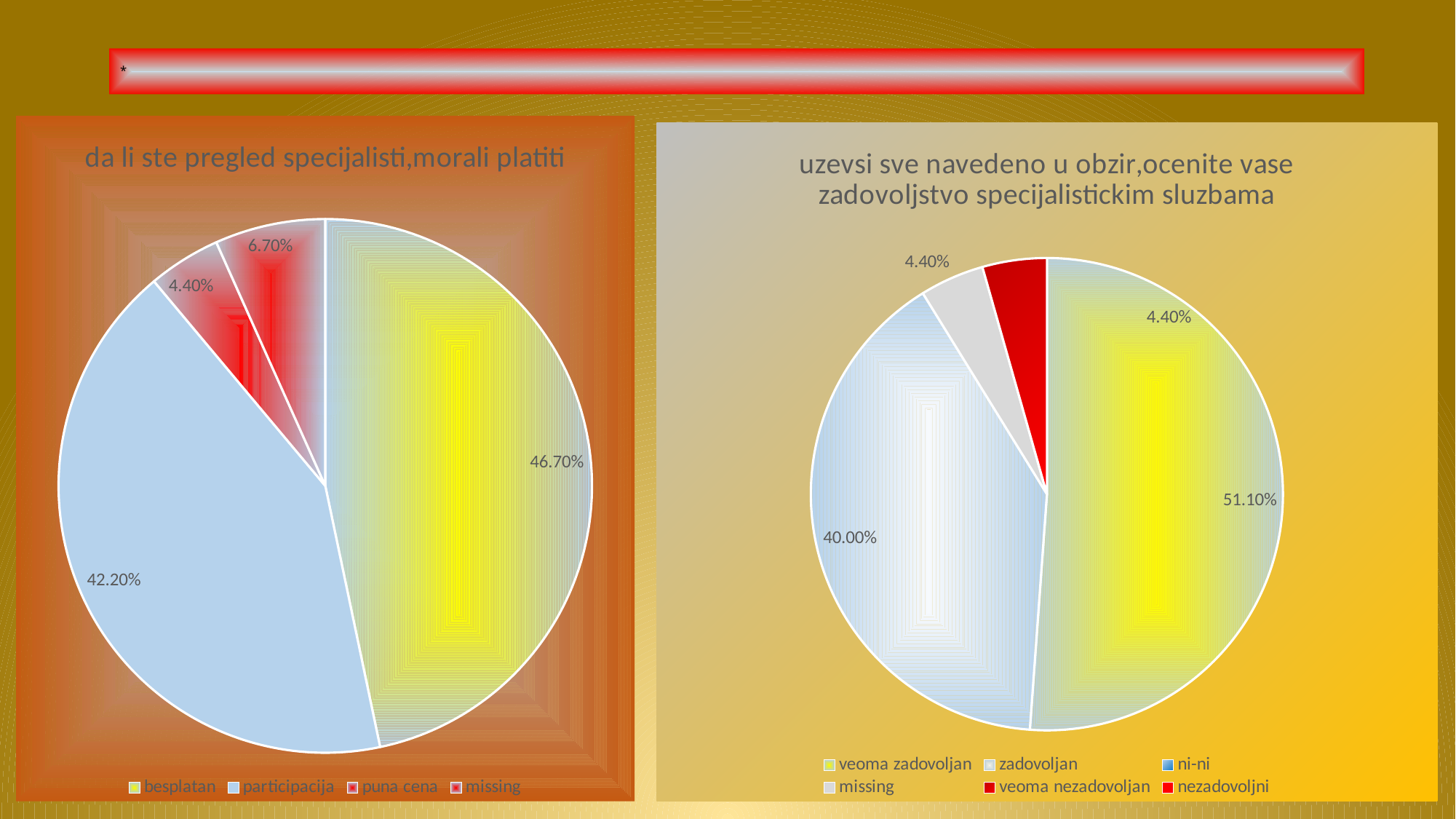
In the left chart "da li ste pregled specijalisti,morali platiti", what is the value for besplatan? 46.70% What kind of chart is the left chart titled "da li ste pregled specijalisti,morali platiti"? pie chart In the right chart "uzevsi sve navedeno u obzir,ocenite vase zadovoljstvo specijalistickim sluzbama", which category has the largest slice? veoma zadovoljan In the right chart "uzevsi sve navedeno u obzir,ocenite vase zadovoljstvo specijalistickim sluzbama", what is the value for zadovoljan? 40.00% In the right chart "uzevsi sve navedeno u obzir,ocenite vase zadovoljstvo specijalistickim sluzbama", what is the value for missing? 4.40% In the left chart "da li ste pregled specijalisti,morali platiti", what is the value for participacija? 42.20% In the right chart "uzevsi sve navedeno u obzir,ocenite vase zadovoljstvo specijalistickim sluzbama", what is the difference between the veoma zadovoljan and zadovoljan values? 11.10% In the right chart "uzevsi sve navedeno u obzir,ocenite vase zadovoljstvo specijalistickim sluzbama", how many entries does the legend list? 6 In the left chart "da li ste pregled specijalisti,morali platiti", which category has the largest slice? besplatan In the left chart "da li ste pregled specijalisti,morali platiti", how many entries does the legend list? 4 In the left chart "da li ste pregled specijalisti,morali platiti", what is the difference between the besplatan and participacija values? 4.50% In the right chart "uzevsi sve navedeno u obzir,ocenite vase zadovoljstvo specijalistickim sluzbama", what is the value for veoma zadovoljan? 51.10%